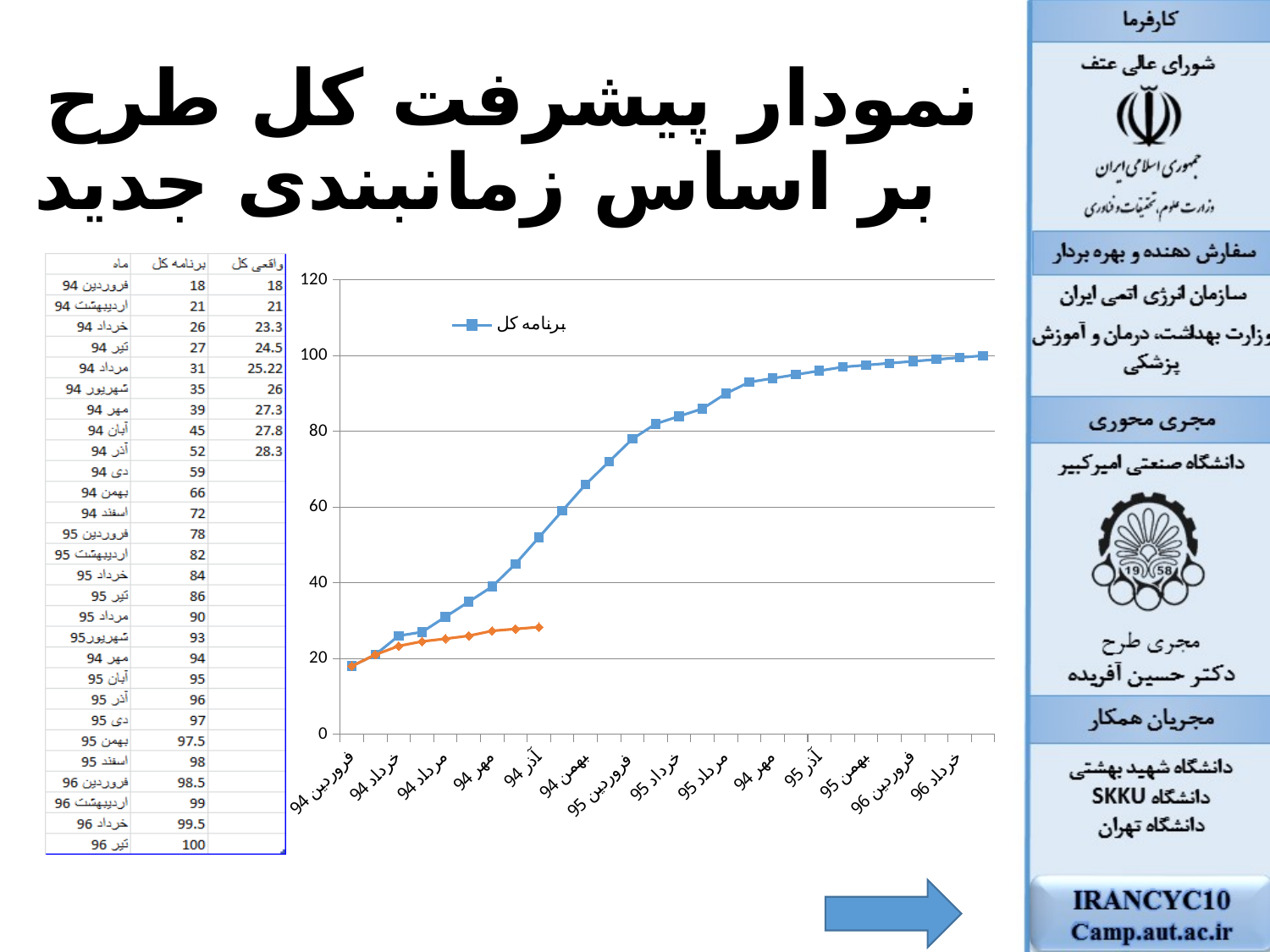
Is the برنامه کل value for خرداد 96 greater or less than 80? greater What kind of chart is shown on the slide? line chart How many series does the chart legend list? 1 What is the value of برنامه کل at تیر 96? 100 At آذر 94, which line is higher: the blue برنامه کل line or the orange line? the blue برنامه کل line Is the برنامه کل value for آذر 94 greater or less than 40? greater What colour is the برنامه کل line in the chart? blue Is the orange line's value at آذر 94 greater or less than 40? less Does the برنامه کل line rise or fall from فروردین 94 to تیر 96? rises At which month does the برنامه کل line reach its highest value? تیر 96 What is the name of the series listed in the chart legend? برنامه کل